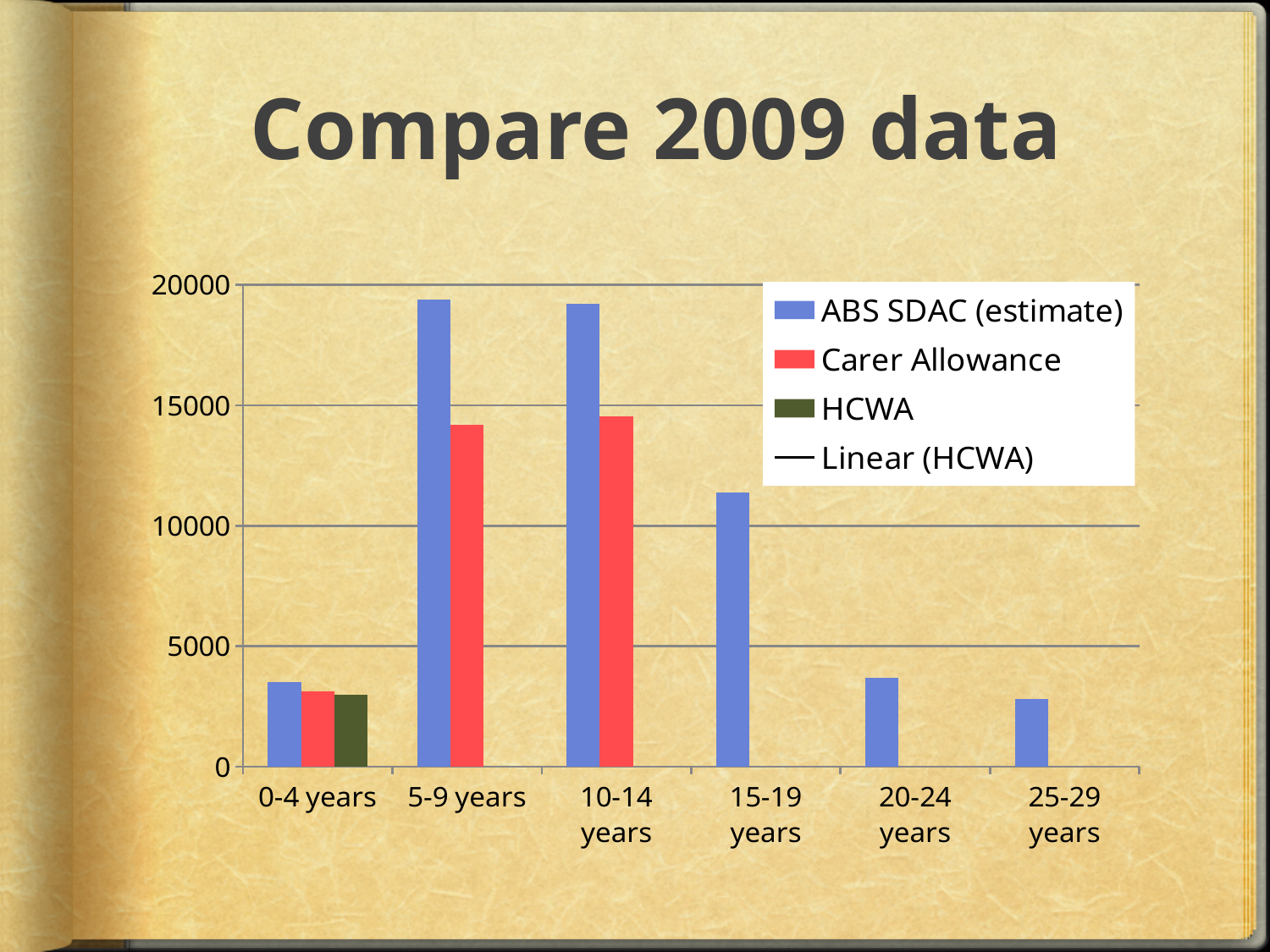
How many entries does the legend list? 4 What kind of chart is shown on the slide? bar chart Is the ABS SDAC (estimate) value for 20-24 years greater or less than 5000? less Which colour represents the Carer Allowance series? red Is the ABS SDAC (estimate) value for 15-19 years greater or less than 10000? greater How many age-group categories are shown on the x axis? 6 Is the Carer Allowance value for 5-9 years greater or less than 15000? less For 5-9 years, which is larger: the ABS SDAC (estimate) value or the Carer Allowance value? ABS SDAC (estimate) Which age group has the lowest ABS SDAC (estimate) value? 25-29 years Which age group has the lowest Carer Allowance value? 0-4 years What is the title of the chart? Compare 2009 data